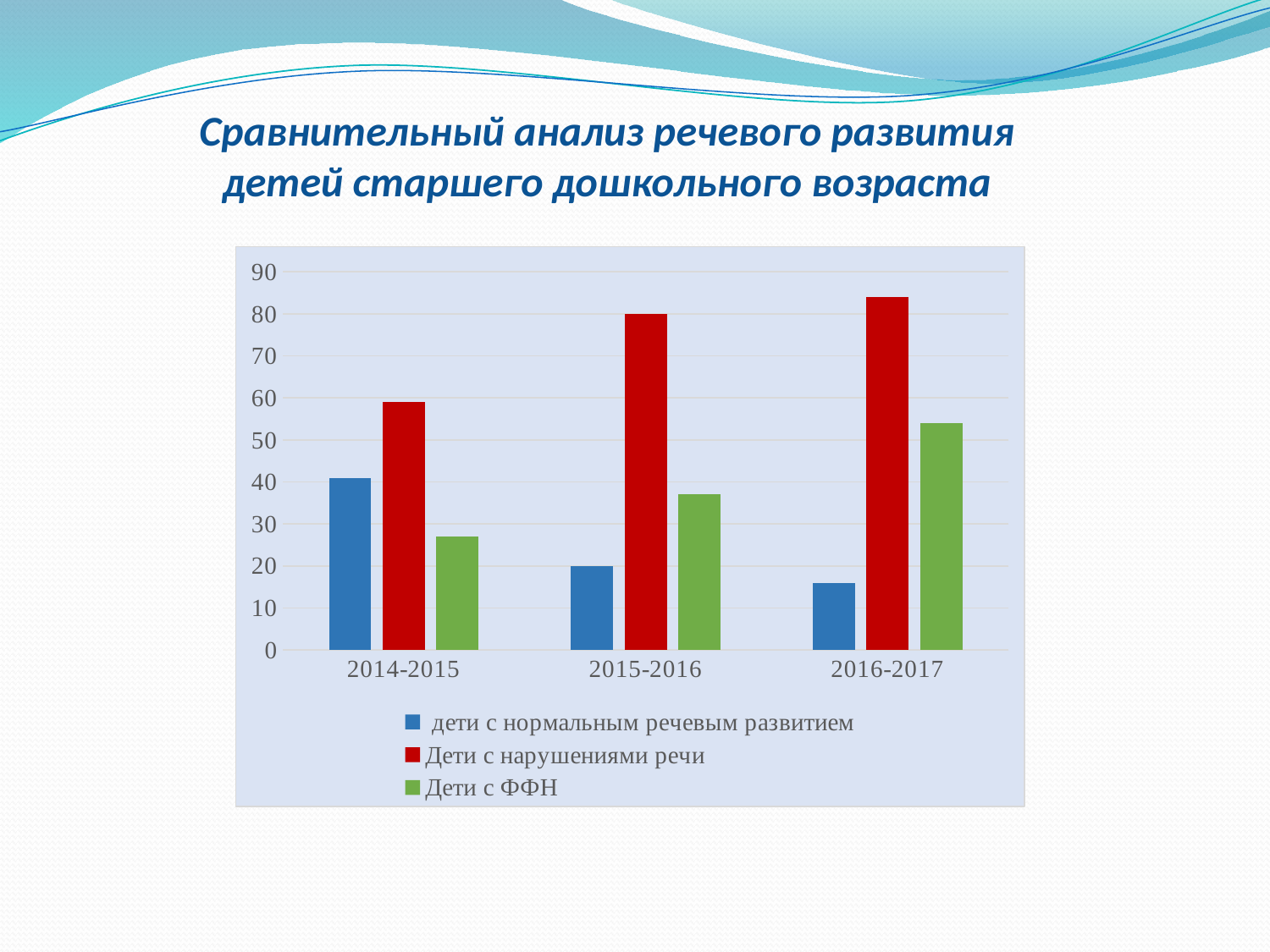
How many series does the legend list? 3 Is the value for Дети с ФФН in 2014-2015 greater or less than 30? less In which year is the value for дети с нормальным речевым развитием the lowest? 2016-2017 What kind of chart is shown on the slide? bar chart Is the value for Дети с нарушениями речи in 2016-2017 greater or less than 80? greater What is the value for Дети с нарушениями речи in 2015-2016? 80 Which is larger in 2016-2017: Дети с ФФН or дети с нормальным речевым развитием? Дети с ФФН In which year is the value for Дети с нарушениями речи the highest? 2016-2017 What is the value for дети с нормальным речевым развитием in 2015-2016? 20 Does the value for дети с нормальным речевым развитием rise or fall from 2014-2015 to 2016-2017? fall How many year categories are shown on the x axis? 3